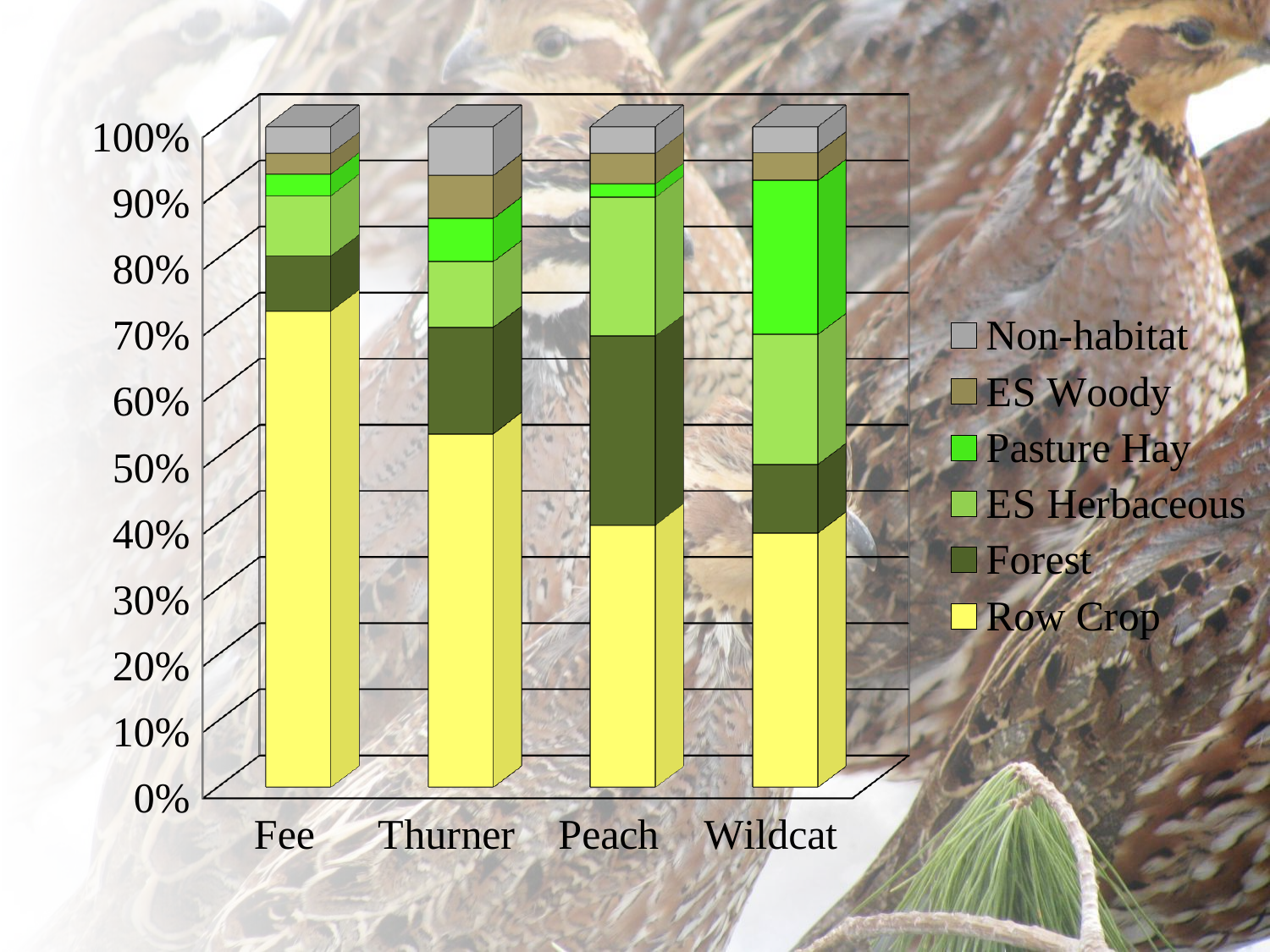
What is the total height of the Fee bar? 100% Which category has the largest Pasture Hay segment? Wildcat Which series is listed last (at the bottom) in the legend? Row Crop Which category has the largest Row Crop share? Fee Is the Row Crop share for Peach greater or less than 50%? less Is the Row Crop share for Fee greater or less than 60%? greater Is the Row Crop share for Thurner greater or less than 60%? less How many categories are shown along the x axis? 4 How many series does the legend list? 6 Which category has the largest Forest segment? Peach Which has the larger Row Crop share, Fee or Thurner? Fee What kind of chart is shown on the slide? Stacked bar chart